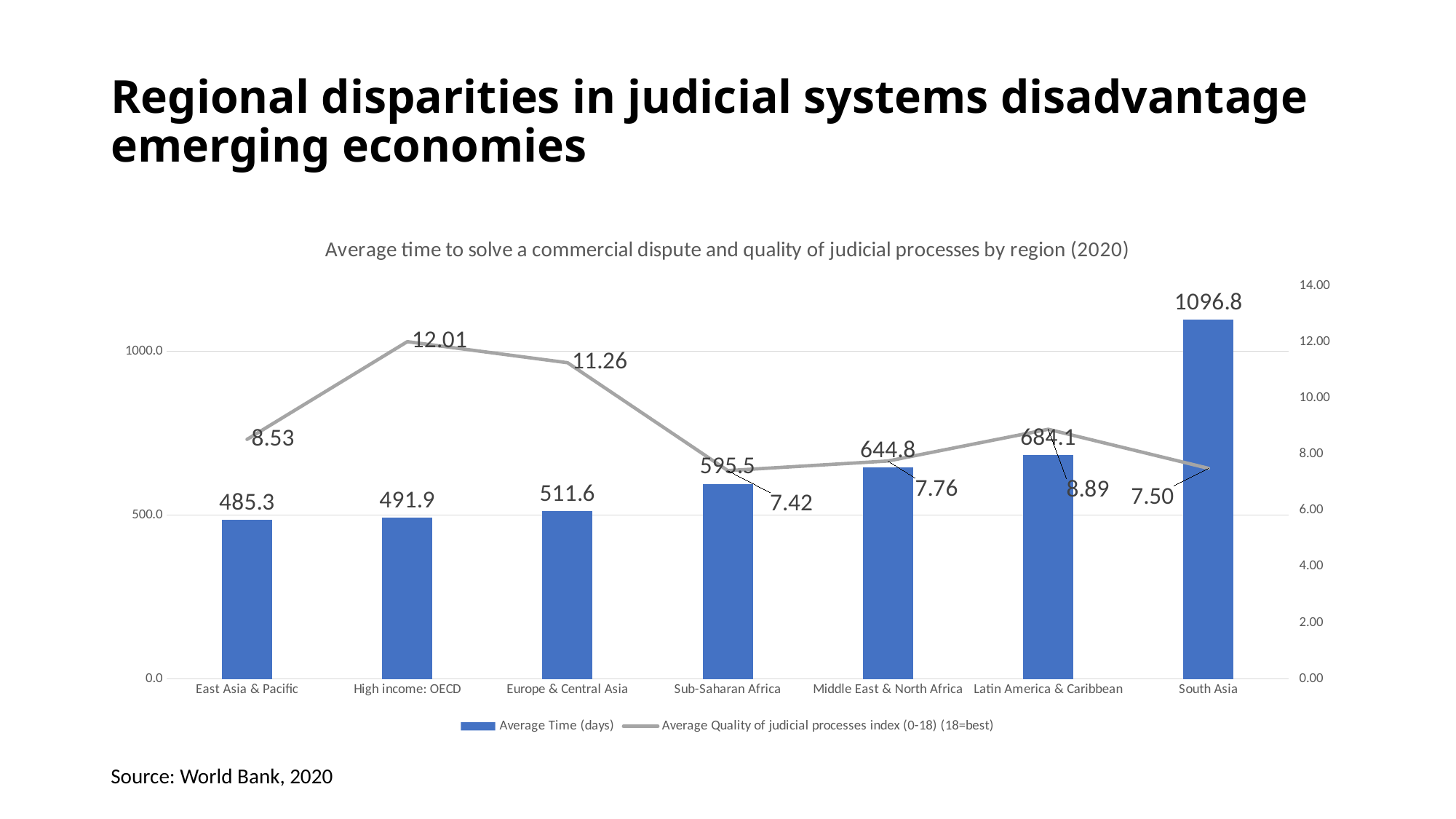
What is the Average Quality of judicial processes index for High income: OECD? 12.01 Which region has the lowest Average Quality of judicial processes index? Sub-Saharan Africa Which region has the highest Average Time (days)? South Asia What is the Average Time (days) for South Asia? 1096.8 Which has a higher Average Quality of judicial processes index, Latin America & Caribbean or Middle East & North Africa? Latin America & Caribbean What is the difference in Average Time (days) between South Asia and East Asia & Pacific? 611.5 How many series does the legend list? 2 What kind of chart is used to show Average Time (days)? Bar chart What is the Average Time (days) for Sub-Saharan Africa? 595.5 Which region has the lowest Average Time (days)? East Asia & Pacific How many regions are shown on the x axis? 7 What is the title of the chart? Average time to solve a commercial dispute and quality of judicial processes by region (2020)